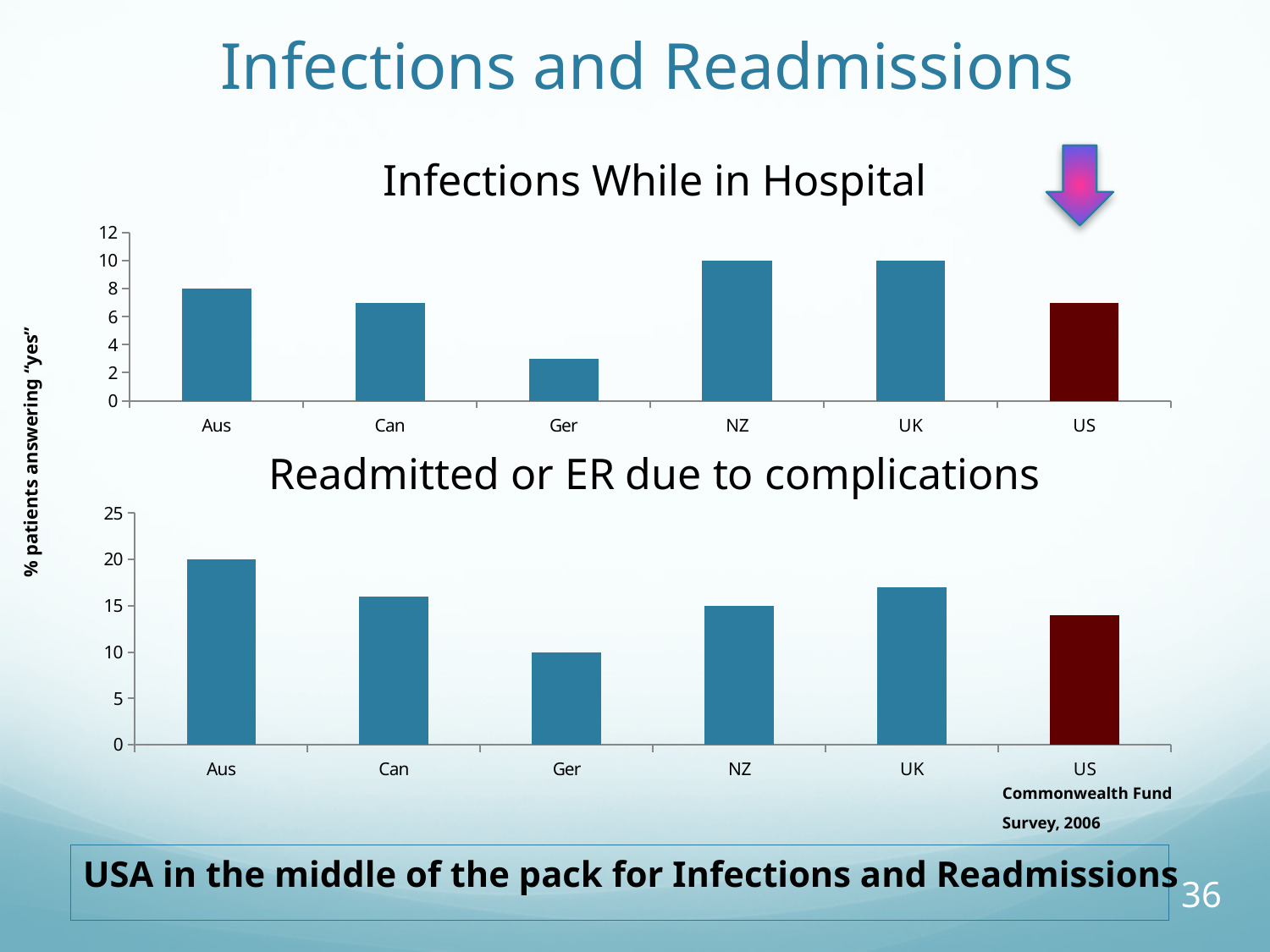
In the 'Infections While in Hospital' chart, is the value for US greater or less than 8? less In the 'Infections While in Hospital' chart, is the value for Ger greater or less than 4? less In the 'Readmitted or ER due to complications' chart, which country has the lowest value? Ger In the 'Infections While in Hospital' chart, which country has the lowest value? Ger How many countries are shown in the 'Infections While in Hospital' chart? 6 In the 'Readmitted or ER due to complications' chart, what is the difference between the values for Aus and Ger? 10 In the 'Infections While in Hospital' chart, what is the value for NZ? 10 In the 'Readmitted or ER due to complications' chart, which country has the highest value? Aus In the 'Infections While in Hospital' chart, what is the difference between the values for NZ and Aus? 2 In the 'Readmitted or ER due to complications' chart, which is larger, the value for UK or the value for US? UK In the 'Infections While in Hospital' chart, what is the value for Aus? 8 In the 'Readmitted or ER due to complications' chart, what is the value for Aus? 20